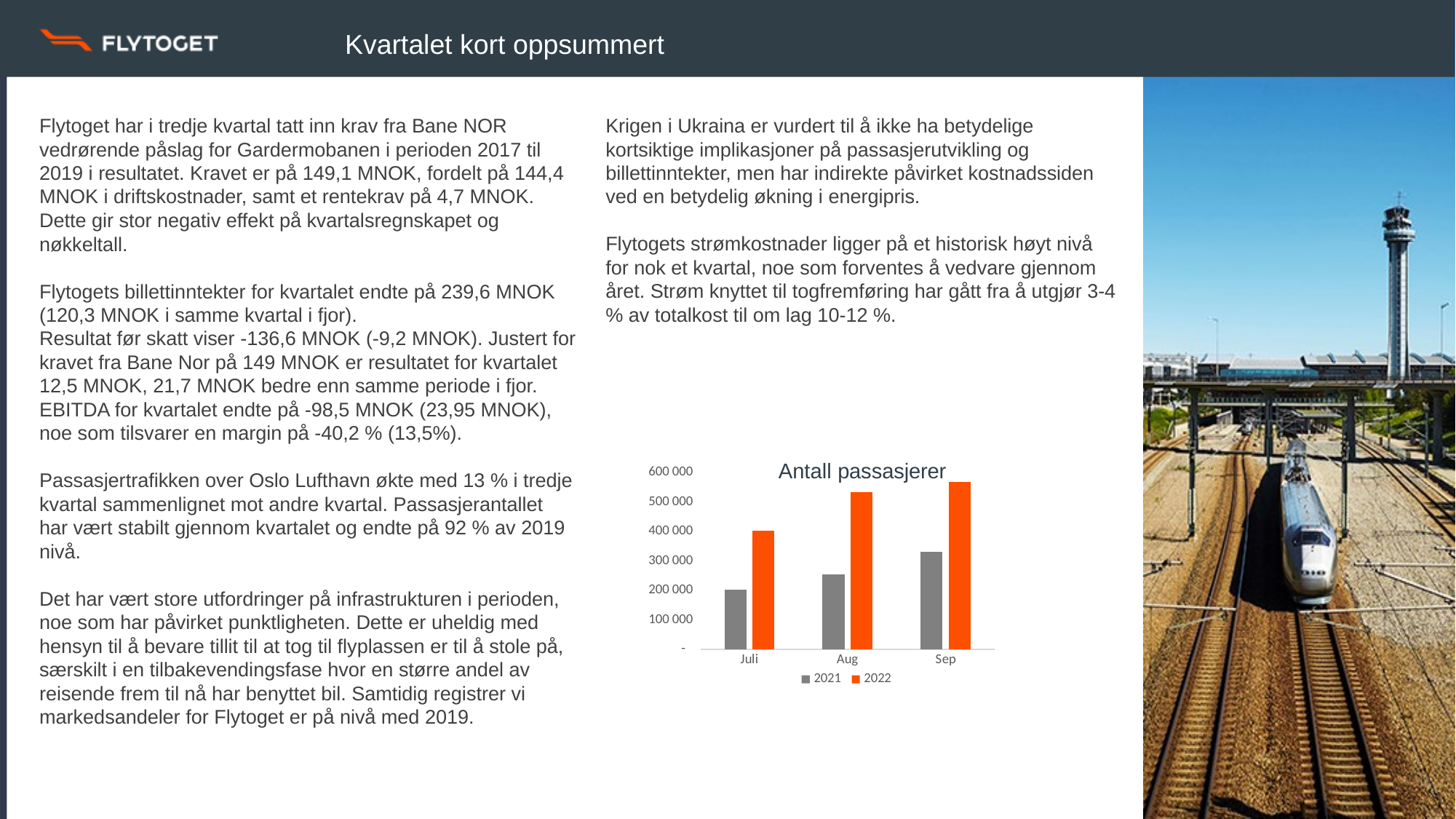
Which month has the highest value for the 2022 series? Sep What kind of chart is shown on the slide? bar chart Is the value for Juli in the 2021 series greater or less than 300 000? less How many series does the chart's legend list? 2 Is the value for Juli in the 2022 series greater or less than 500 000? less How many months are shown on the x axis of the chart? 3 Is the value for Aug in the 2022 series greater or less than 500 000? greater Which colour represents the 2022 series in the chart? orange What is the title of the chart? Antall passasjerer Which month has the lowest value for the 2021 series? Juli Do the values for the 2022 series rise or fall from Juli to Sep? rise